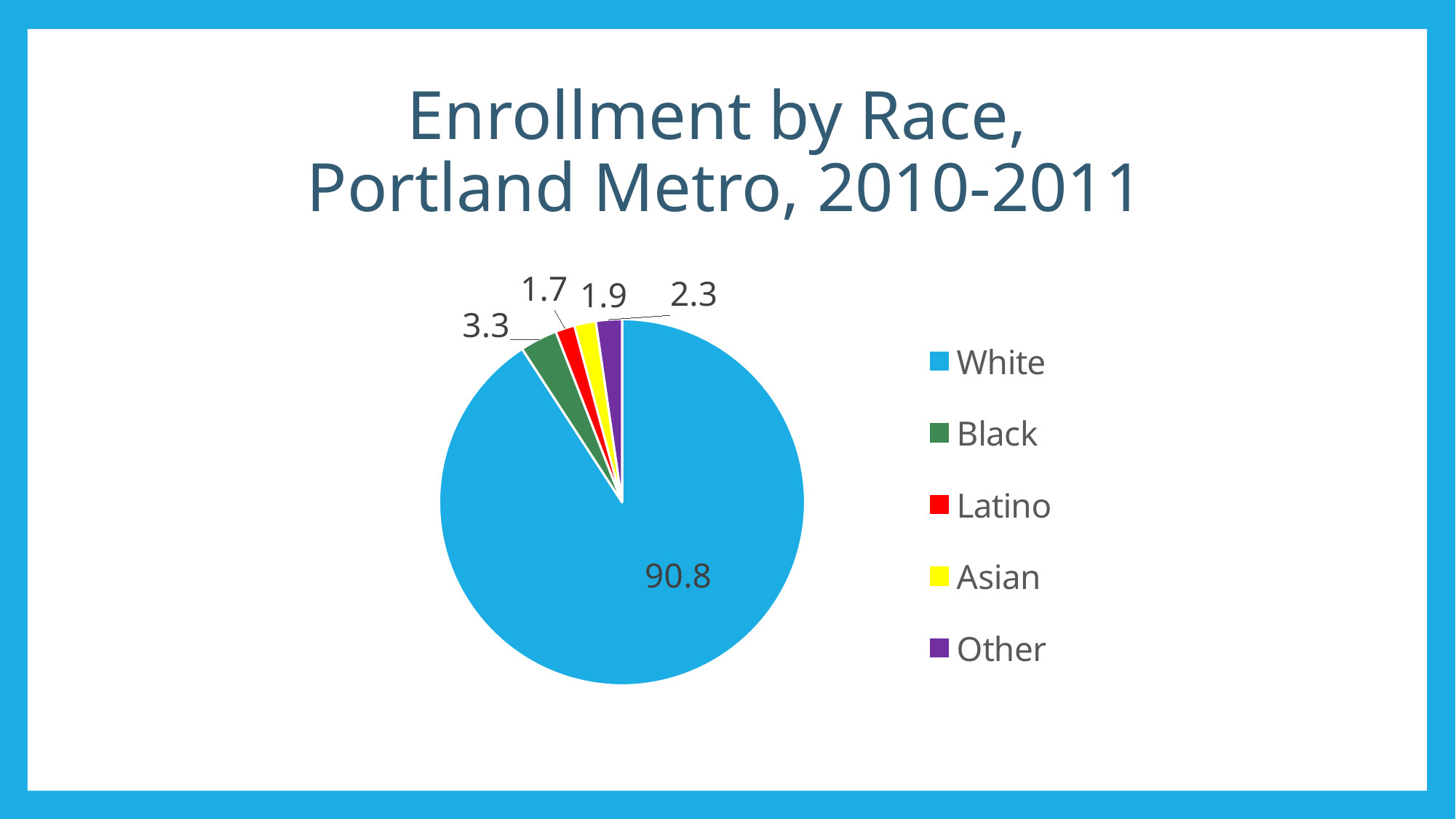
What is the value for Asian? 1.9 What kind of chart is shown on the slide? pie chart Which is larger, the value for Black or the value for Other? Black How many categories does the legend list? 5 Which category has the largest slice? White What is the value for Other? 2.3 What is the value for White? 90.8 What is the value for Black? 3.3 What is the difference between the values for White and Black? 87.5 What is the title of the chart? Enrollment by Race, Portland Metro, 2010-2011 Which category has the smallest slice? Latino What is the value for Latino? 1.7